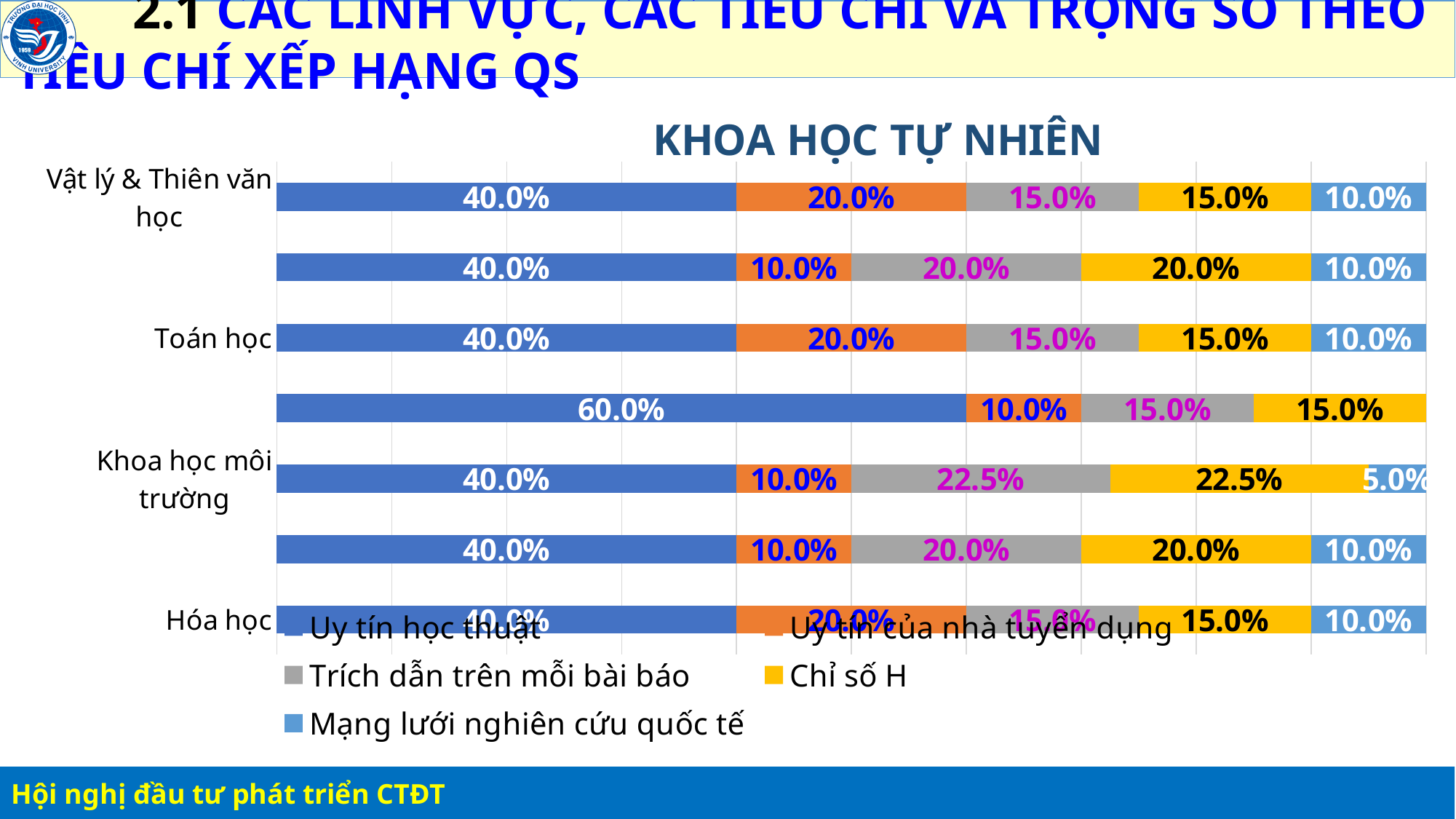
What is the title of the chart? KHOA HỌC TỰ NHIÊN What kind of chart is shown on the slide? bar chart What is the value of Uy tín học thuật for Vật lý & Thiên văn học? 40.0% What is the difference between the Trích dẫn trên mỗi bài báo values for Khoa học môi trường and Toán học? 7.5 percentage points What is the value of Chỉ số H for Khoa học môi trường? 22.5% How many series does the legend of the KHOA HỌC TỰ NHIÊN chart list? 5 What is the value of Mạng lưới nghiên cứu quốc tế for Khoa học môi trường? 5.0% Which has the larger Mạng lưới nghiên cứu quốc tế value, Toán học or Khoa học môi trường? Toán học How many bars are plotted in the KHOA HỌC TỰ NHIÊN chart? 7 Which series has the largest share in the Toán học bar? Uy tín học thuật What is the value of Uy tín của nhà tuyển dụng for Toán học? 20.0% What is the value of Chỉ số H for Hóa học? 15.0%